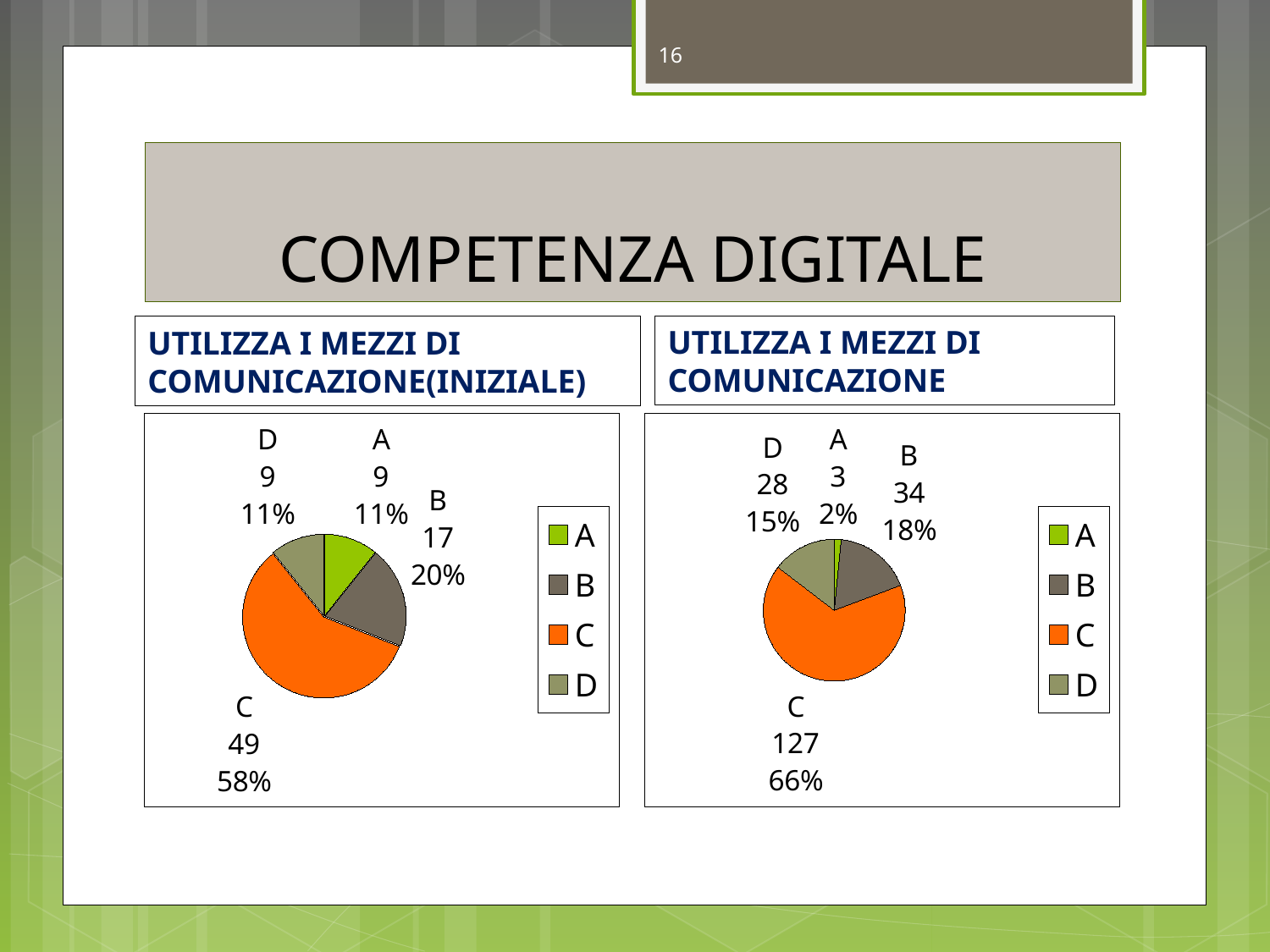
In the right chart (UTILIZZA I MEZZI DI COMUNICAZIONE), what is the difference between the values for C and B? 93 In the right chart (UTILIZZA I MEZZI DI COMUNICAZIONE), which category has the lowest value? A In the left chart (UTILIZZA I MEZZI DI COMUNICAZIONE(INIZIALE)), what percentage share does category B have? 20% In the left chart (UTILIZZA I MEZZI DI COMUNICAZIONE(INIZIALE)), what is the difference between the values for B and A? 8 How many categories does the left chart (UTILIZZA I MEZZI DI COMUNICAZIONE(INIZIALE)) show? 4 In the left chart (UTILIZZA I MEZZI DI COMUNICAZIONE(INIZIALE)), what is the value for category C? 49 What kind of chart is the right chart (UTILIZZA I MEZZI DI COMUNICAZIONE)? pie chart In the right chart (UTILIZZA I MEZZI DI COMUNICAZIONE), which is larger, the value for B or the value for D? B In the right chart (UTILIZZA I MEZZI DI COMUNICAZIONE), what is the value for category D? 28 In the left chart (UTILIZZA I MEZZI DI COMUNICAZIONE(INIZIALE)), which category has the highest value? C In the right chart (UTILIZZA I MEZZI DI COMUNICAZIONE), what percentage share does category C have? 66% In the right chart (UTILIZZA I MEZZI DI COMUNICAZIONE), which colour represents category C in the legend? orange